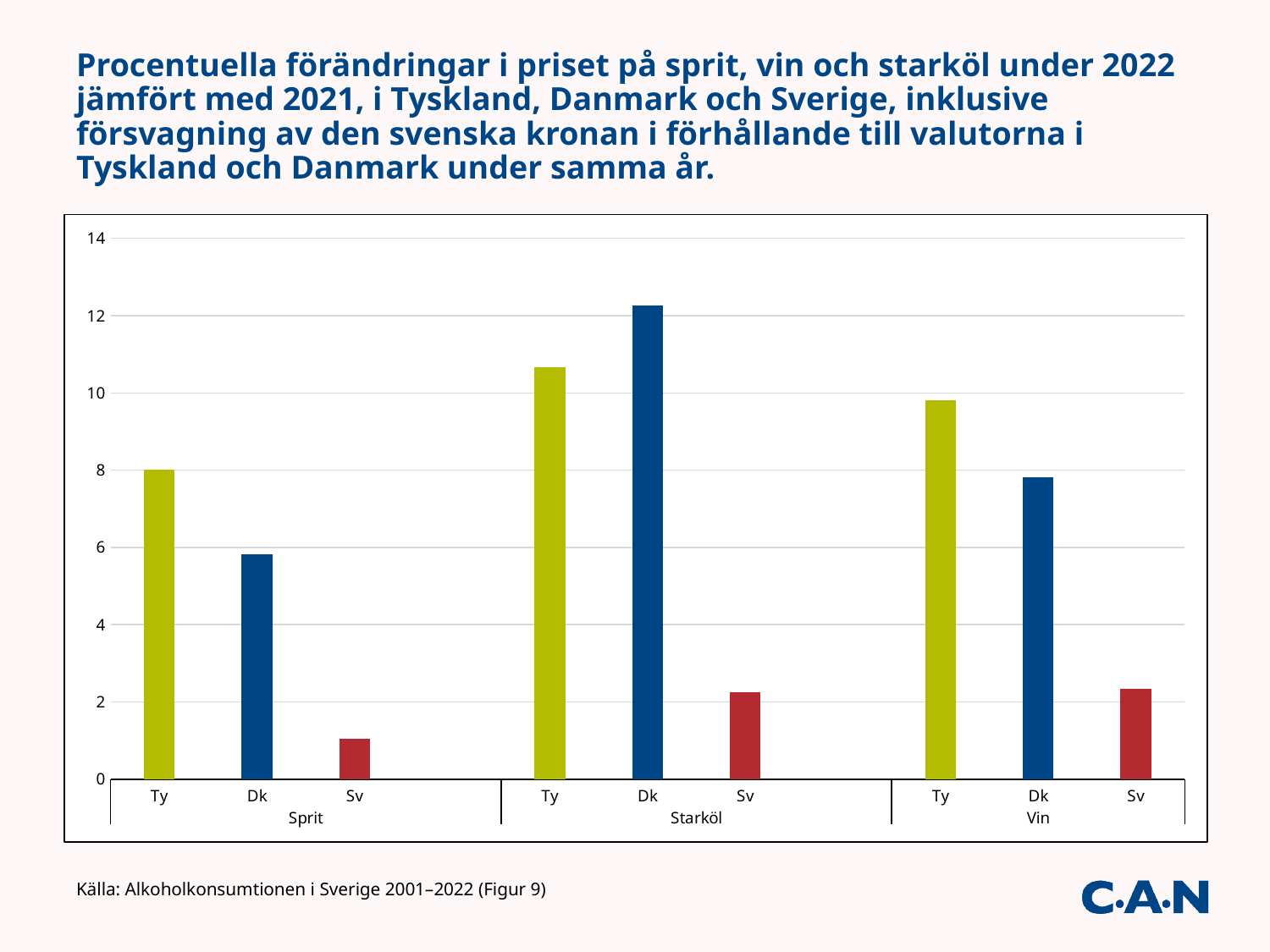
Is the value for Dk in Starköl greater or less than 12? greater What is the source cited below the chart? Alkoholkonsumtionen i Sverige 2001–2022 (Figur 9) Is the value for Dk in Sprit greater or less than 6? less Within the Sprit group, which country has the highest bar? Ty Which bar is the lowest in the chart? Sv in Sprit Which bar is the highest in the chart? Dk in Starköl Within the Vin group, which country has the lowest bar? Sv Is the value for Ty in Vin greater or less than 10? less Which is larger: the value for Ty in Starköl or the value for Ty in Vin? Ty in Starköl What kind of chart is shown on the slide? bar chart How many product groups (Sprit, Starköl, Vin) are shown on the x axis? 3 How many bars are plotted in the chart? 9